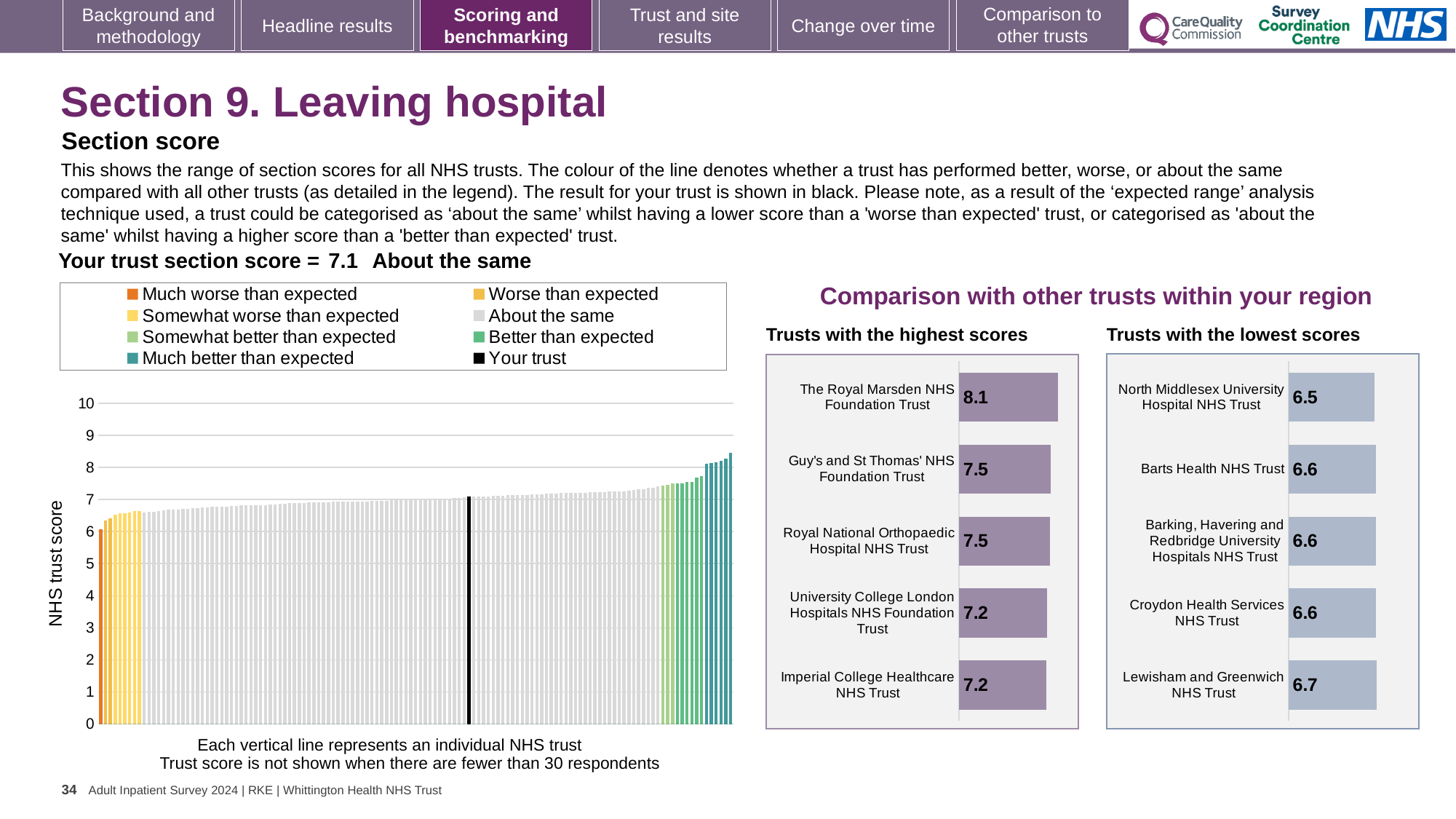
In the 'Trusts with the highest scores' chart, which has the higher score: The Royal Marsden NHS Foundation Trust or Guy's and St Thomas' NHS Foundation Trust? The Royal Marsden NHS Foundation Trust How many entries does the legend of the large 'NHS trust score' chart list? 8 In the 'Trusts with the highest scores' chart, what is the score for The Royal Marsden NHS Foundation Trust? 8.1 In the 'Trusts with the lowest scores' chart, what is the difference between the scores of Lewisham and Greenwich NHS Trust and North Middlesex University Hospital NHS Trust? 0.2 In the large 'NHS trust score' chart, is the value of the tallest bar greater or less than 8? greater In the 'Trusts with the highest scores' chart, which trust has the highest score? The Royal Marsden NHS Foundation Trust In the large 'NHS trust score' chart, what is the section score for your trust (the black bar)? 7.1 What kind of chart is the large 'NHS trust score' chart on the left of the slide? Bar chart In the 'Trusts with the lowest scores' chart, which trust has the lowest score? North Middlesex University Hospital NHS Trust In the 'Trusts with the highest scores' chart, what is the difference between the scores of The Royal Marsden NHS Foundation Trust and Imperial College Healthcare NHS Trust? 0.9 How many trusts are shown in the 'Trusts with the lowest scores' chart? 5 In the 'Trusts with the lowest scores' chart, what is the score for North Middlesex University Hospital NHS Trust? 6.5